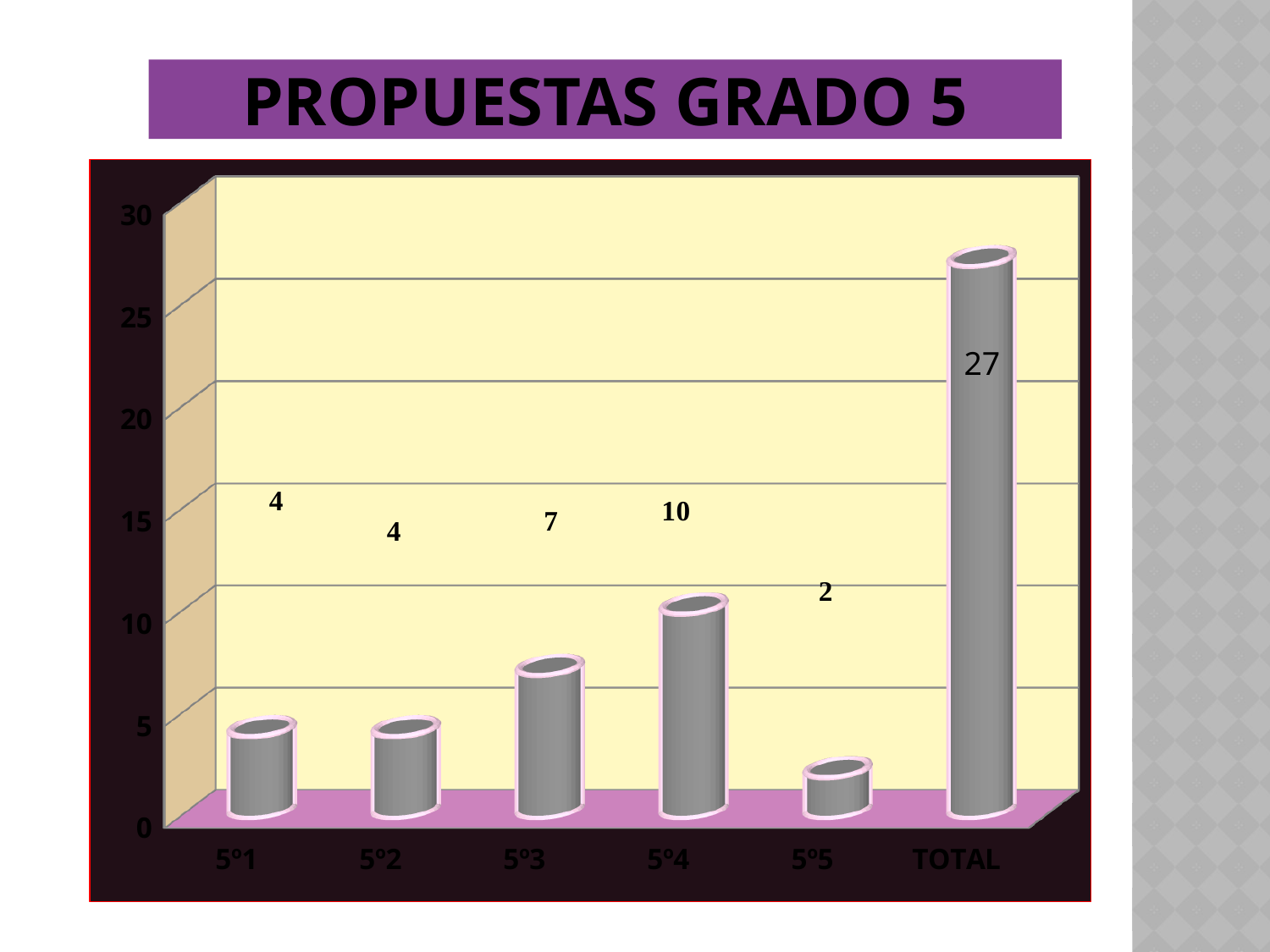
What is the value for TOTAL? 27 What is the value for 5º3? 7 What is the title of the chart? PROPUESTAS GRADO 5 What kind of chart is shown on the slide? bar chart What is the difference between the values for 5º4 and 5º3? 3 What is the value for 5º1? 4 Which category has the lowest value? 5º5 What is the value for 5º5? 2 Which category has the highest value? TOTAL How many categories are shown on the x axis? 6 What is the value for 5º4? 10 Which is larger, the value for 5º3 or the value for 5º5? 5º3